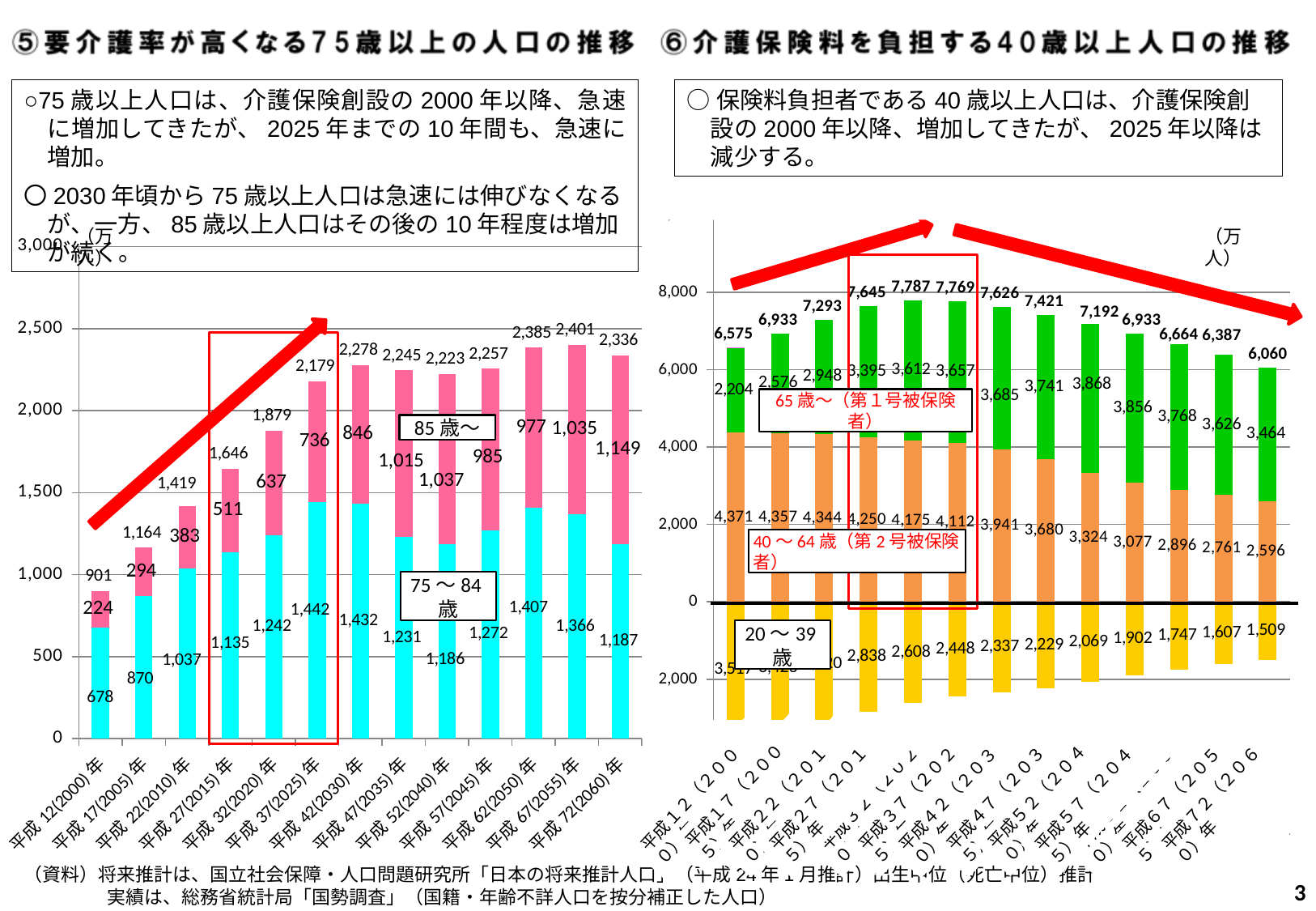
In the left chart (⑤ 75歳以上の人口の推移), how many years are shown on the x axis? 13 In the right chart (⑥ 40歳以上人口の推移), what is the difference between the 20～39歳 value for 2030 and for 2060? 828 In the left chart (⑤ 75歳以上の人口の推移), what is the 75～84歳 value for 平成12(2000)年? 678 In the left chart (⑤ 75歳以上の人口の推移), which year has the lowest total 75歳以上 population? 平成12(2000)年 In the left chart (⑤ 75歳以上の人口の推移), what is the total 75歳以上 population for 平成37(2025)年? 2,179 In the right chart (⑥ 40歳以上人口の推移), which is larger: the 40～64歳 value for 2000 or the 40～64歳 value for 2060? 2000 In the right chart (⑥ 40歳以上人口の推移), what is the total 40歳以上 population for the 2020 bar? 7,787 In the left chart (⑤ 75歳以上の人口の推移), what is the difference between the total for 平成37(2025)年 and the total for 平成27(2015)年? 533 In the left chart (⑤ 75歳以上の人口の推移), what is the 85歳～ value for 平成72(2060)年? 1,149 In the left chart (⑤ 75歳以上の人口の推移), which year has the highest total 75歳以上 population? 平成67(2055)年 In the right chart (⑥ 40歳以上人口の推移), what is the 65歳～ value for the 2060 bar? 3,464 What kind of chart is the left chart (⑤ 75歳以上の人口の推移)? Stacked bar chart